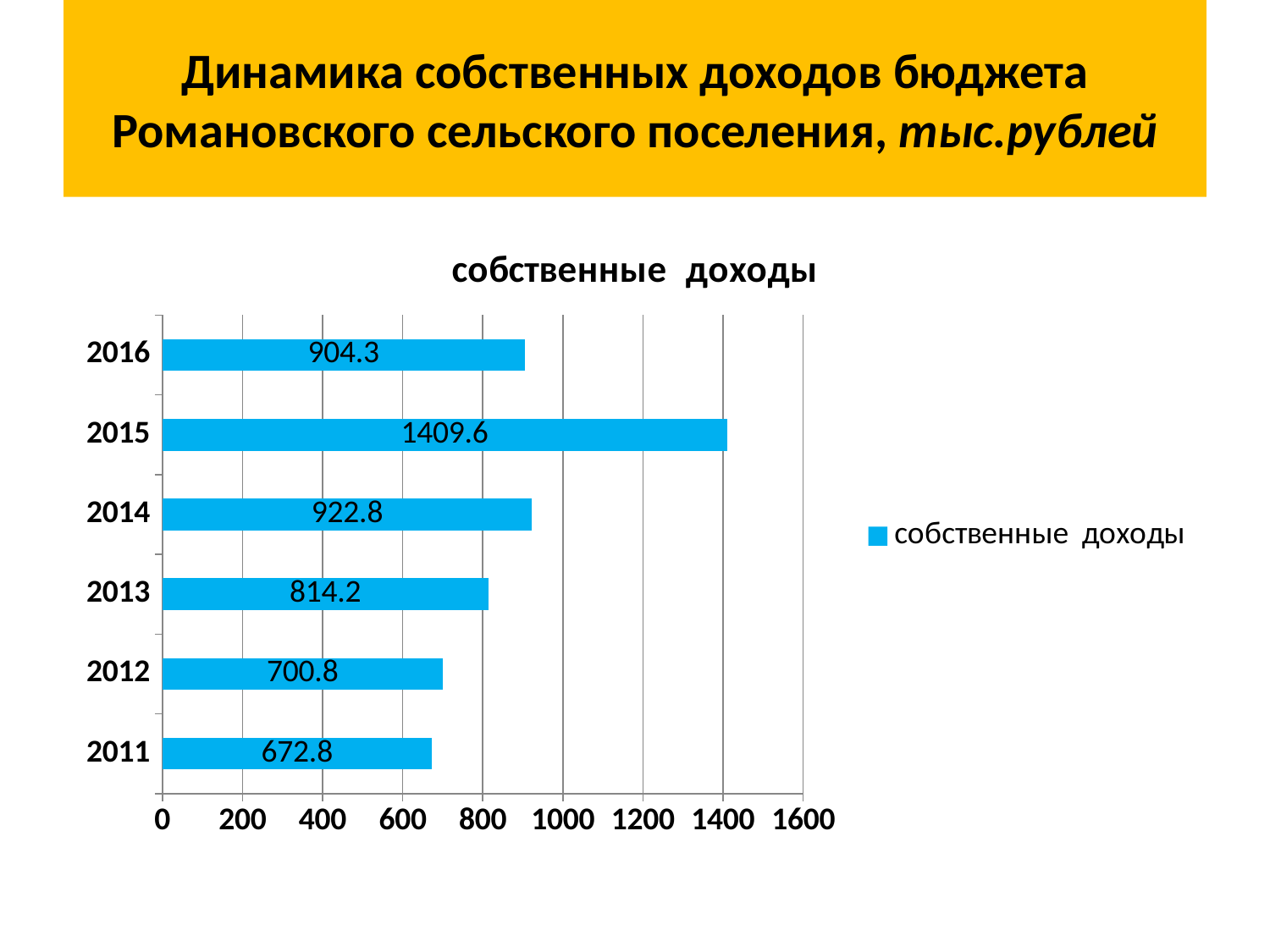
What is the value for 2013 in the chart? 814.2 How many years are shown in the chart? 6 Is the value for 2012 greater or less than 800? less What is the value for 2011 in the chart? 672.8 What is the difference between the values for 2015 and 2016? 505.3 What is the value for 2015 in the chart? 1409.6 Which is larger, the value for 2014 or the value for 2016? 2014 Which year has the lowest value in the chart? 2011 Which year has the highest value in the chart? 2015 What is the title of the chart? собственные доходы What is the difference between the values for 2014 and 2013? 108.6 What kind of chart is shown on the slide? bar chart